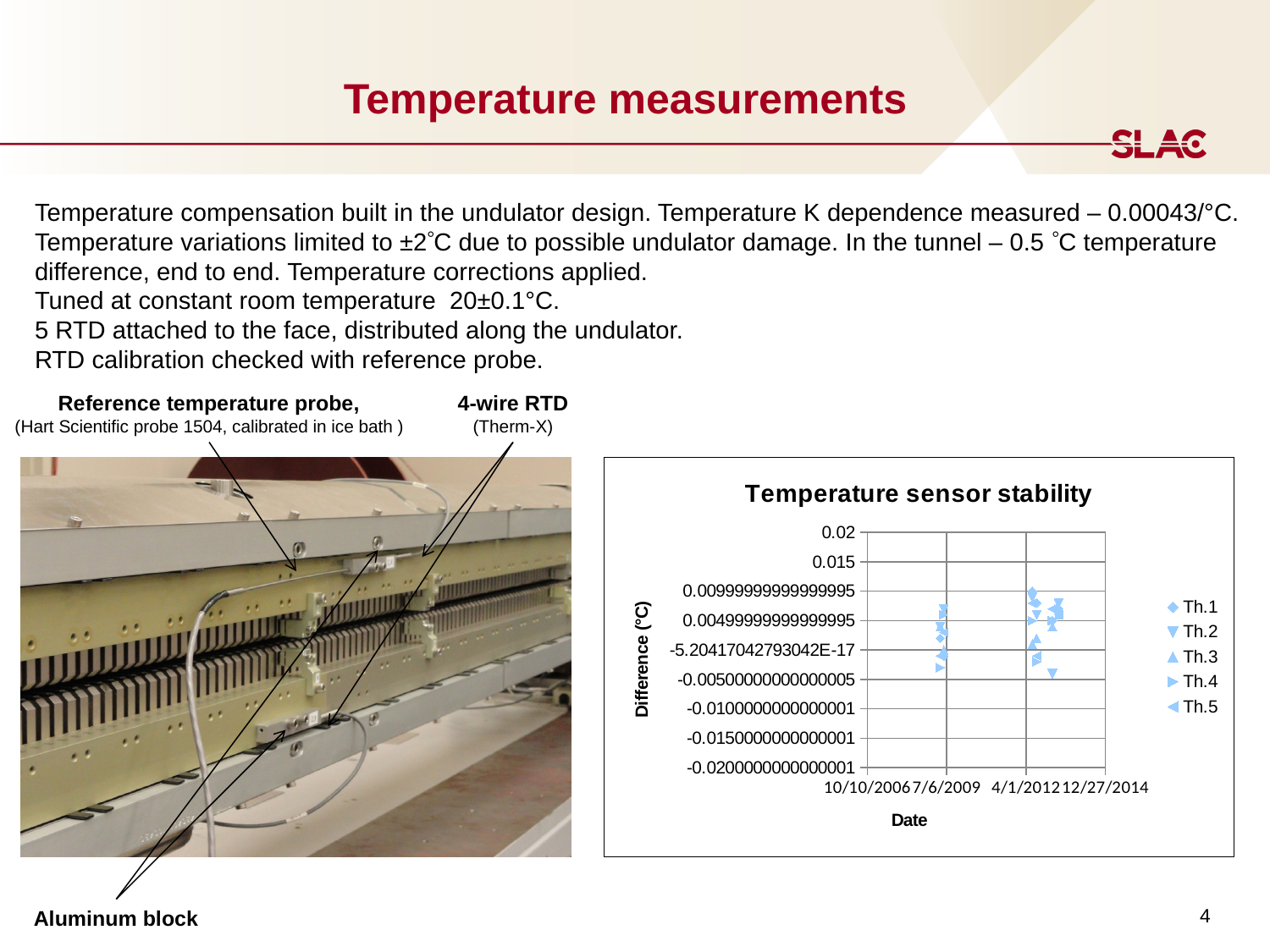
What is the topmost tick label on the y axis of the "Temperature sensor stability" chart? 0.02 What is the first date tick label on the x axis of the "Temperature sensor stability" chart? 10/10/2006 In the "Temperature sensor stability" chart, is the lowest plotted point greater or less than -0.01? greater What is the y-axis title of the "Temperature sensor stability" chart? Difference (°C) What kind of chart is "Temperature sensor stability"? scatter chart What is the last date tick label on the x axis of the "Temperature sensor stability" chart? 12/27/2014 What is the x-axis title of the "Temperature sensor stability" chart? Date What is the title of the chart on the slide? Temperature sensor stability What are the legend entries of the "Temperature sensor stability" chart? Th.1, Th.2, Th.3, Th.4, Th.5 How many series does the legend of the "Temperature sensor stability" chart list? 5 In the "Temperature sensor stability" chart, is the highest plotted point greater or less than 0.015? less How many date tick labels are shown on the x axis of the "Temperature sensor stability" chart? 4